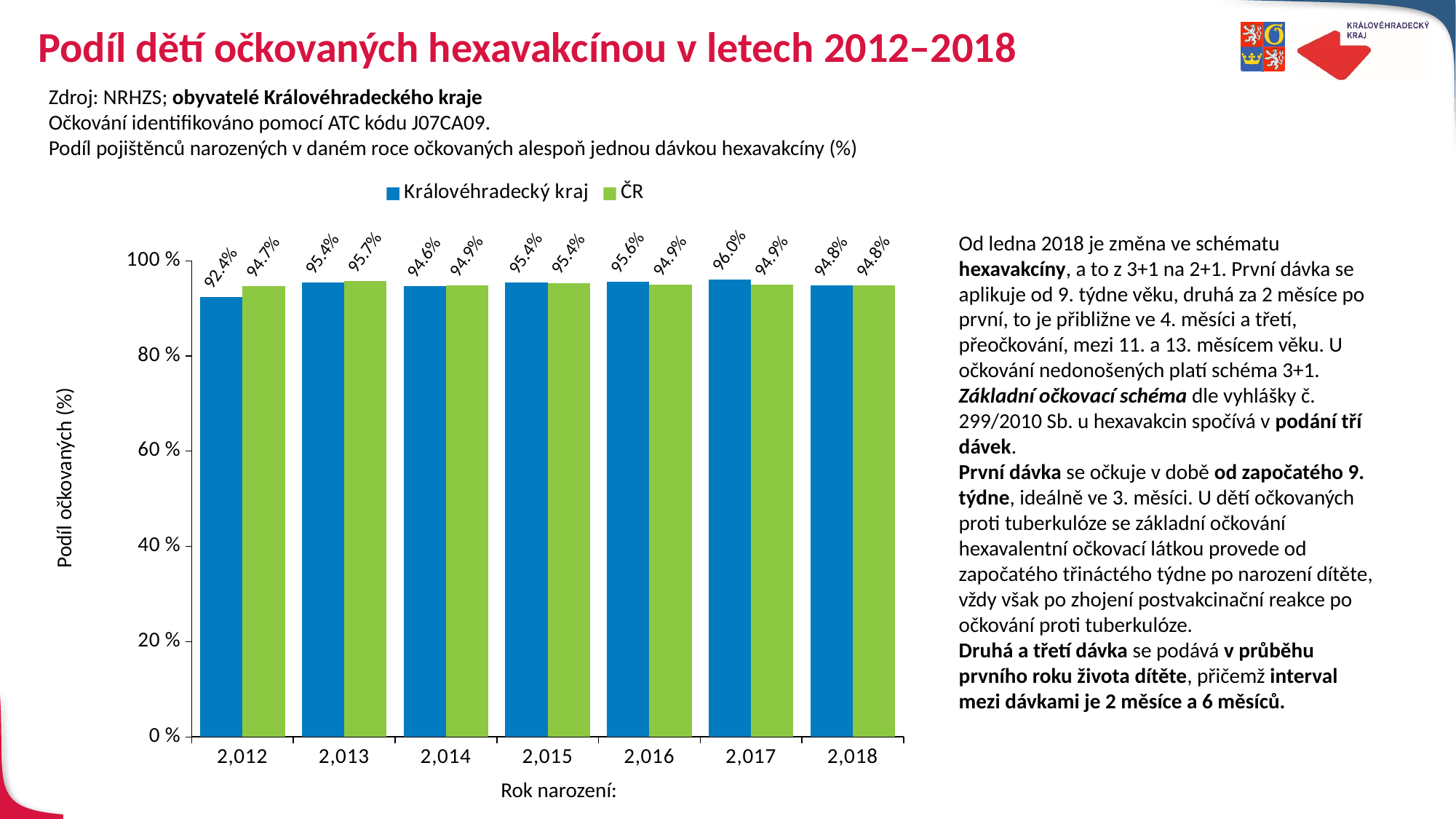
In which birth year does ČR have its highest value? 2013 In which birth year does Královéhradecký kraj have its lowest share of vaccinated children? 2012 Which series is shown in green in the legend? ČR What is the value for Královéhradecký kraj in 2012? 92.4% What is the value for Královéhradecký kraj in 2017? 96.0% How many birth years are shown on the x axis? 7 How many series does the legend list? 2 By how many percentage points does ČR exceed Královéhradecký kraj in 2012? 2.3 In which birth year does Královéhradecký kraj have its highest share of vaccinated children? 2017 What is the value for ČR in 2013? 95.7% What type of chart is shown on the slide? Bar chart In 2016, which series has the higher value, Královéhradecký kraj or ČR? Královéhradecký kraj